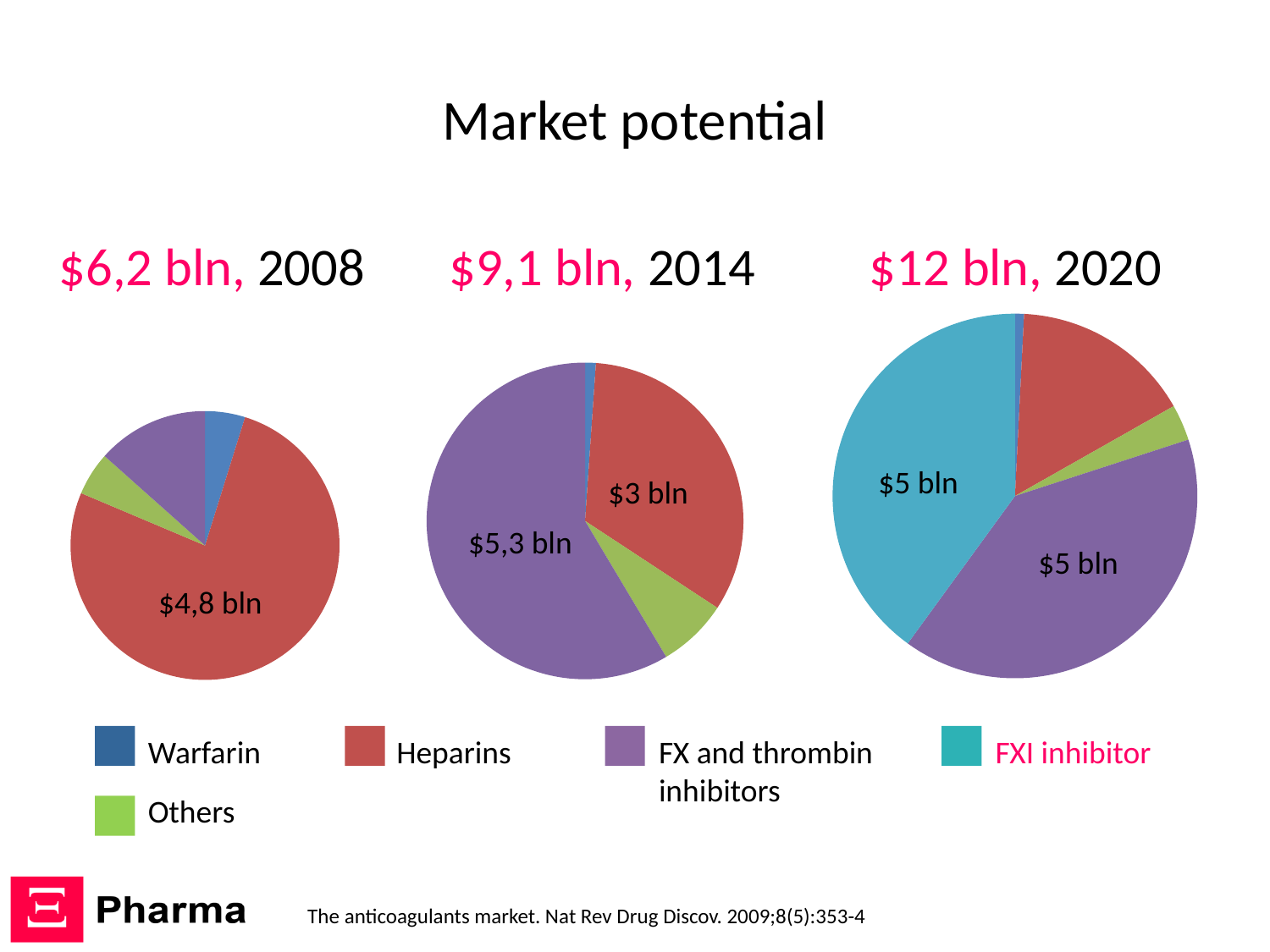
In the 2014 pie chart, which category has the smallest slice? Warfarin What kind of charts are shown on the slide? Pie charts In the 2008 pie chart, which category has the largest slice? Heparins In the 2008 pie chart, what is the value shown for Heparins? $4,8 bln What is the total market value shown for 2020? $12 bln In the 2014 pie chart, what is the value shown for FX and thrombin inhibitors? $5,3 bln In the 2020 pie chart, what is the value shown for FXI inhibitor? $5 bln In the 2014 pie chart, what is the value shown for Heparins? $3 bln In the 2014 pie chart, which category has the largest slice? FX and thrombin inhibitors In the 2014 pie chart, what is the difference between the FX and thrombin inhibitors value and the Heparins value? $2,3 bln In the 2014 pie chart, which is larger: Heparins or FX and thrombin inhibitors? FX and thrombin inhibitors How many categories does the legend list? 5